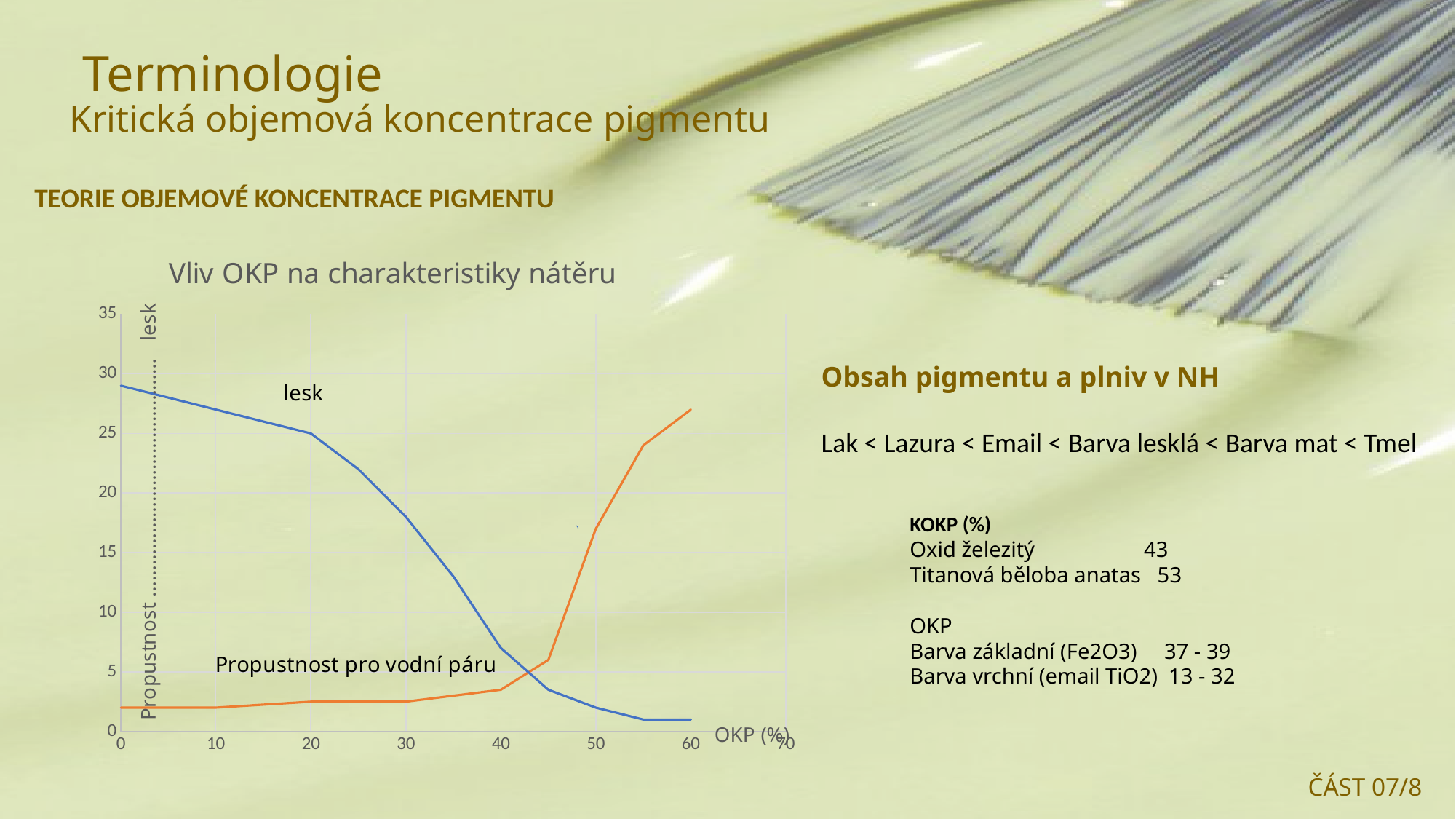
Does the 'Propustnost pro vodní páru' line rise or fall as OKP increases along the x axis? rise At OKP 60, which series has the higher value, 'lesk' or 'Propustnost pro vodní páru'? Propustnost pro vodní páru Is the value of 'Propustnost pro vodní páru' at OKP 60 greater or less than 20? greater Is the value of 'lesk' at OKP 0 greater or less than 25? greater Is the value of 'lesk' at OKP 60 greater or less than 5? less How many data series are plotted in the chart? 2 What kind of chart is shown on the slide? line chart What is the title of the chart? Vliv OKP na charakteristiky nátěru Does the 'lesk' line rise or fall as OKP increases along the x axis? fall What is the label of the x axis of the chart? OKP (%) At OKP 10, which series has the higher value, 'lesk' or 'Propustnost pro vodní páru'? lesk